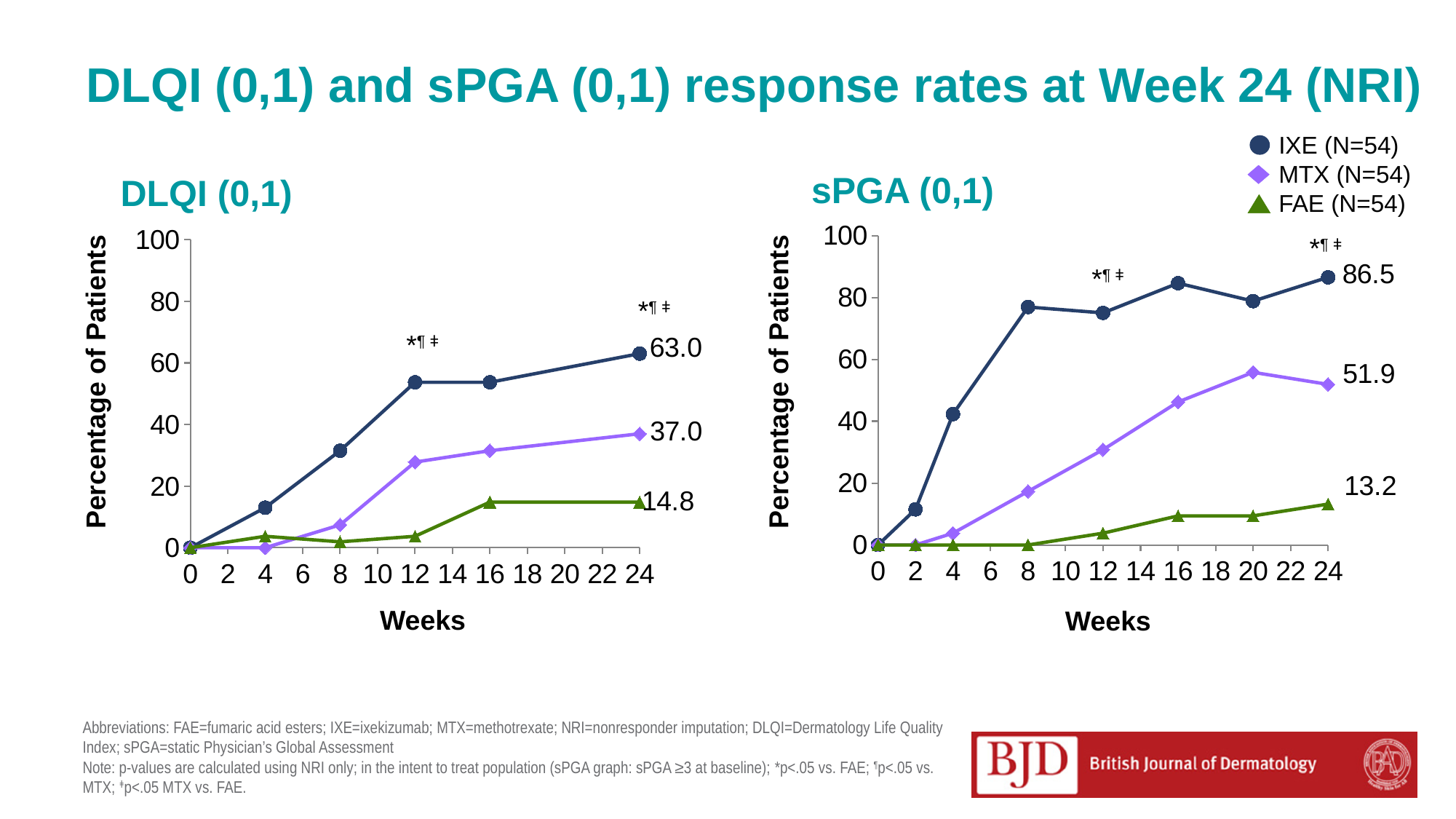
In the DLQI (0,1) chart, what is the value for FAE at week 24? 14.8 What kind of chart is the sPGA (0,1) chart? Line chart In the sPGA (0,1) chart, is the value for IXE at week 8 greater or less than 60? greater In the sPGA (0,1) chart, what is the value for IXE at week 24? 86.5 In the DLQI (0,1) chart, which treatment has the lowest value at week 24? FAE How many series does the legend list? 3 In the sPGA (0,1) chart, which treatment has the highest value at week 24? IXE In the DLQI (0,1) chart, what is the difference between the IXE and MTX values at week 24? 26.0 In the sPGA (0,1) chart, what is the value for FAE at week 24? 13.2 In the DLQI (0,1) chart, what is the value for MTX at week 24? 37.0 In the sPGA (0,1) chart, what is the value for MTX at week 24? 51.9 In the DLQI (0,1) chart, what is the value for IXE at week 24? 63.0